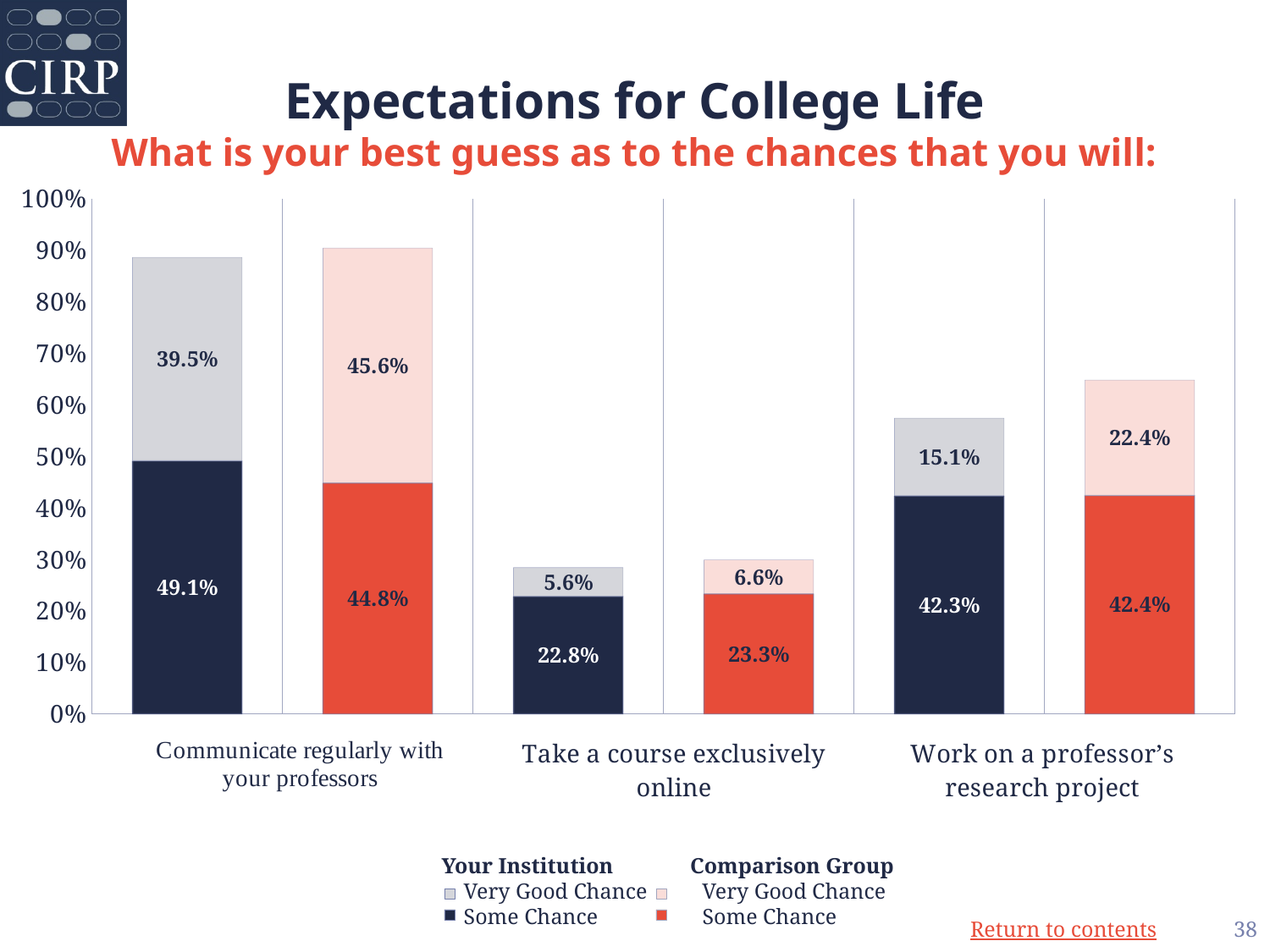
What is the 'Very Good Chance' value for the Comparison Group for 'Work on a professor's research project'? 22.4% What is the total of the stacked bar for the Comparison Group for 'Take a course exclusively online'? 29.9% Which category has the highest 'Very Good Chance' value for the Comparison Group? Communicate regularly with your professors For 'Communicate regularly with your professors', which is larger: the Comparison Group 'Very Good Chance' value or the Your Institution 'Very Good Chance' value? Comparison Group What is the difference between the Comparison Group and Your Institution 'Very Good Chance' values for 'Work on a professor's research project'? 7.3% How many series does the legend list? 4 What is the total of the stacked bar for Your Institution for 'Work on a professor's research project'? 57.4% What kind of chart is shown on the slide? Stacked bar chart How many categories are shown on the x axis? 3 What is the 'Some Chance' value for Your Institution for 'Communicate regularly with your professors'? 49.1% What is the 'Very Good Chance' value for Your Institution for 'Take a course exclusively online'? 5.6% Which category has the lowest 'Some Chance' value for Your Institution? Take a course exclusively online